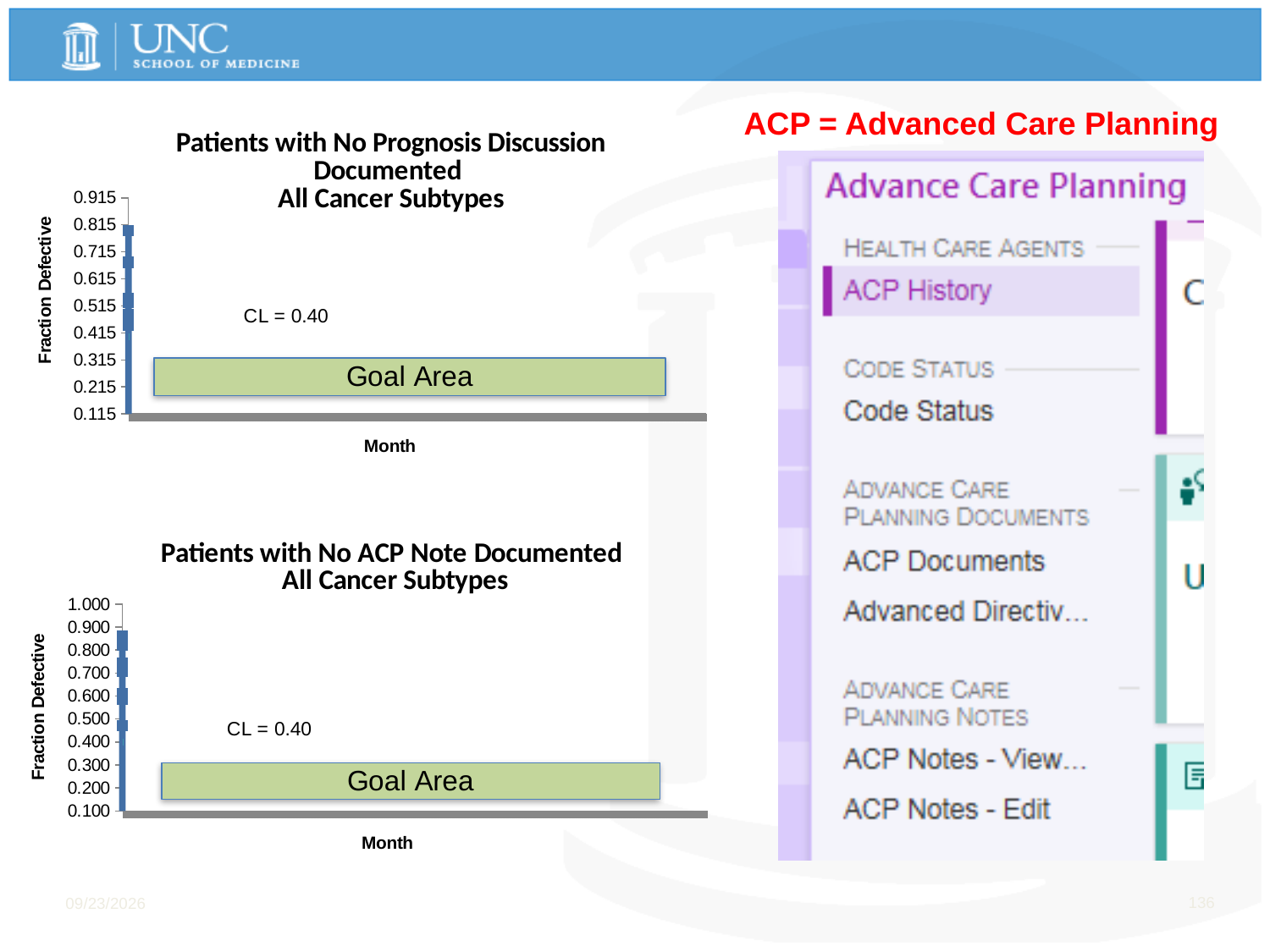
In the bottom chart (Patients with No ACP Note Documented), what is the CL value shown? CL = 0.40 In the bottom chart (Patients with No ACP Note Documented), what is the highest tick value on the y axis? 1.000 What label is written on the green shaded box in each chart? Goal Area What is the title of the top chart on the slide? Patients with No Prognosis Discussion Documented All Cancer Subtypes In the top chart (Patients with No Prognosis Discussion Documented), what is the lowest tick value on the y axis? 0.115 In the top chart (Patients with No Prognosis Discussion Documented), what is the CL value shown? CL = 0.40 In the top chart (Patients with No Prognosis Discussion Documented), what is the highest tick value on the y axis? 0.915 What is the title of the bottom chart on the slide? Patients with No ACP Note Documented All Cancer Subtypes In the bottom chart (Patients with No ACP Note Documented), what is the lowest tick value on the y axis? 0.100